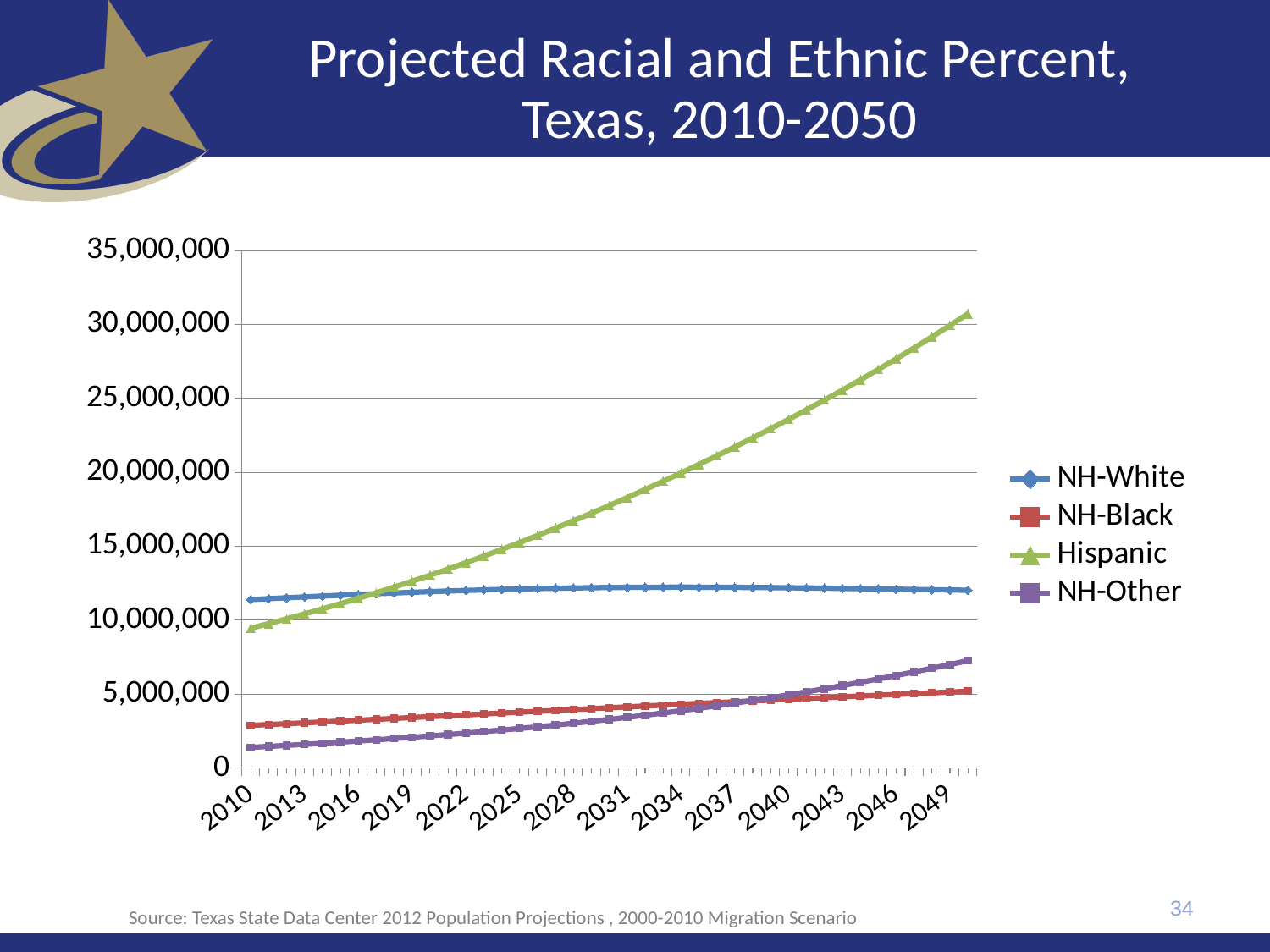
Which series has the lowest value in 2010? NH-Other Is the value for NH-Other in 2050 greater or less than 5,000,000? greater Is the value for NH-White in 2010 greater or less than 10,000,000? greater What kind of chart is shown on the slide? line chart Does the NH-Other series rise or fall from 2010 to 2050? rise Which series has the highest value in 2050? Hispanic Does the Hispanic series rise or fall from 2010 to 2050? rise What is the title of the chart on the slide? Projected Racial and Ethnic Percent, Texas, 2010-2050 How many series does the legend list? 4 Is the value for Hispanic in 2050 greater or less than 25,000,000? greater In 2010, which is larger: NH-Black or NH-Other? NH-Black In 2050, which is larger: NH-Black or NH-Other? NH-Other